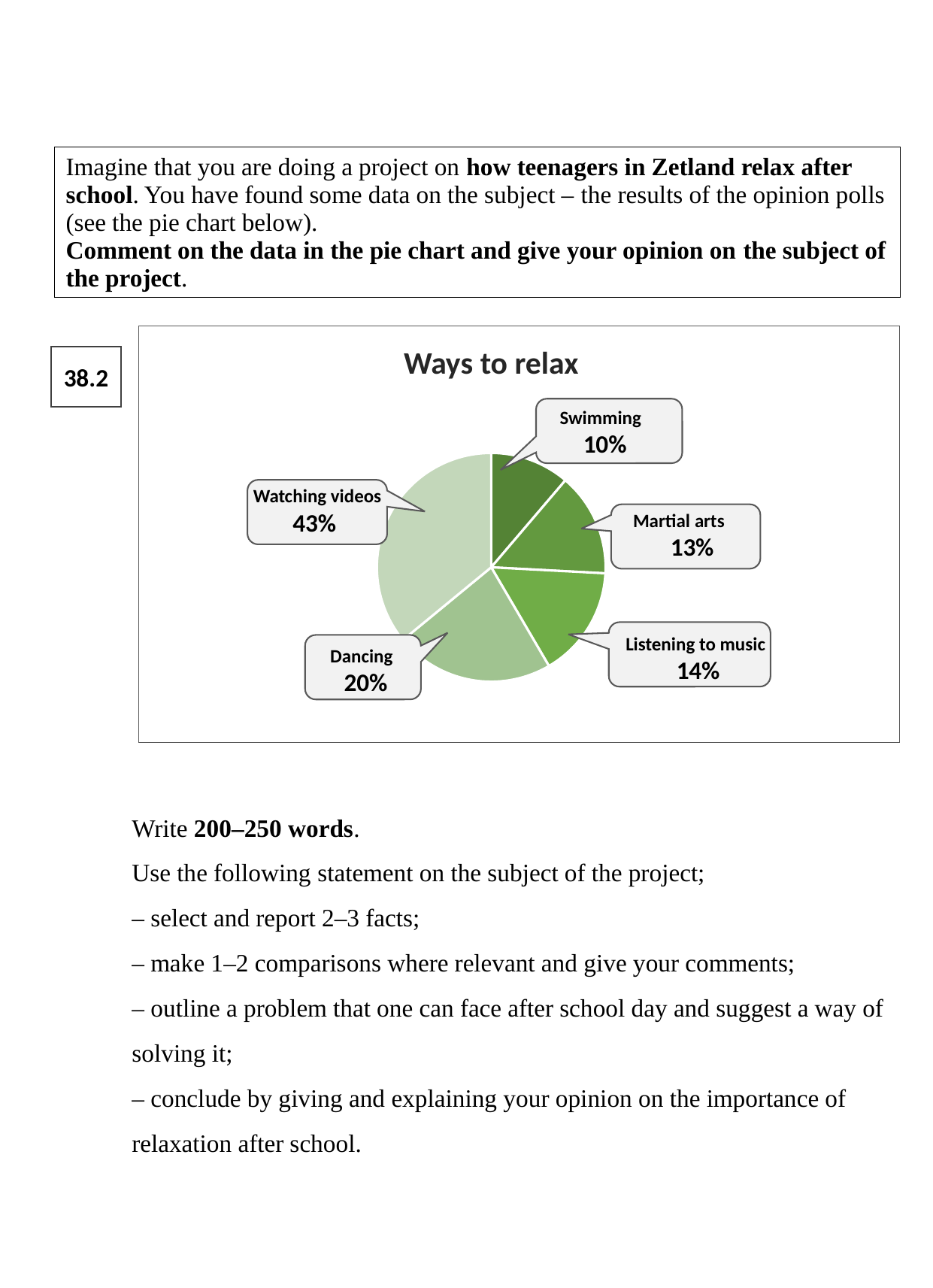
What share of the pie chart is Martial arts? 13% How many categories are shown in the pie chart? 5 What is the title of the chart? Ways to relax What kind of chart is shown on the slide? Pie chart What is the difference between the shares for Watching videos and Dancing? 23% What is the difference between the shares for Listening to music and Swimming? 4% Which way to relax has the largest share in the pie chart? Watching videos What is the value for Swimming in the pie chart? 10% What percentage of teenagers relax by watching videos? 43% What is the combined share of Swimming and Martial arts? 23% Which way to relax has the smallest share in the pie chart? Swimming Which is larger, the share for Dancing or the share for Listening to music? Dancing